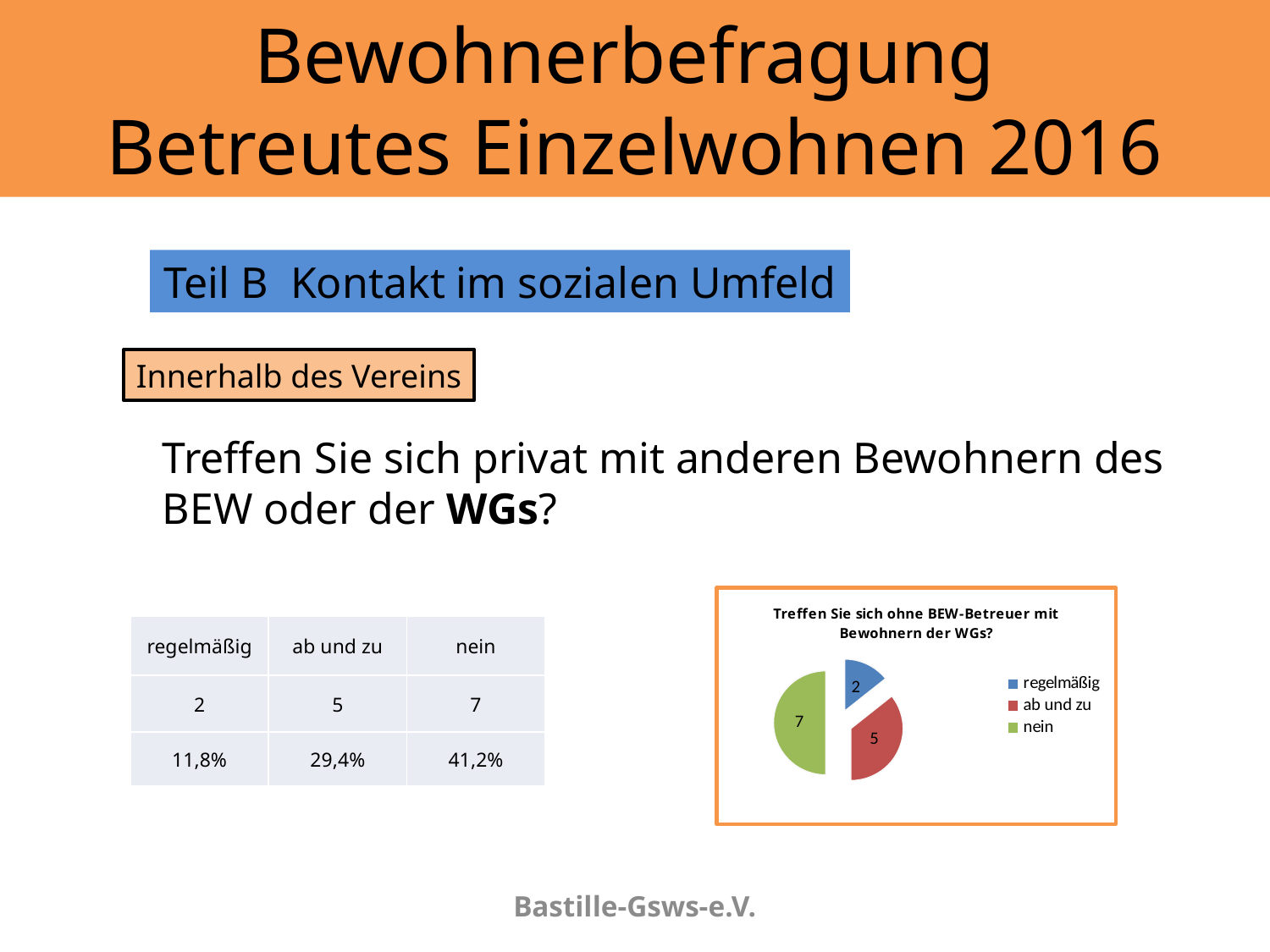
What is the difference between the values for "nein" and "regelmäßig" in the pie chart? 5 What colour is the "nein" slice in the pie chart? green What is the value for "ab und zu" in the pie chart? 5 What kind of chart is shown on the slide? pie chart What is the title of the pie chart? Treffen Sie sich ohne BEW-Betreuer mit Bewohnern der WGs? What is the difference between the values for "ab und zu" and "regelmäßig" in the pie chart? 3 How many slices does the pie chart have? 3 Which category has the largest slice in the pie chart? nein What is the value for "nein" in the pie chart? 7 Which category has the smallest slice in the pie chart? regelmäßig Which is larger in the pie chart, "ab und zu" or "nein"? nein What is the value for "regelmäßig" in the pie chart? 2